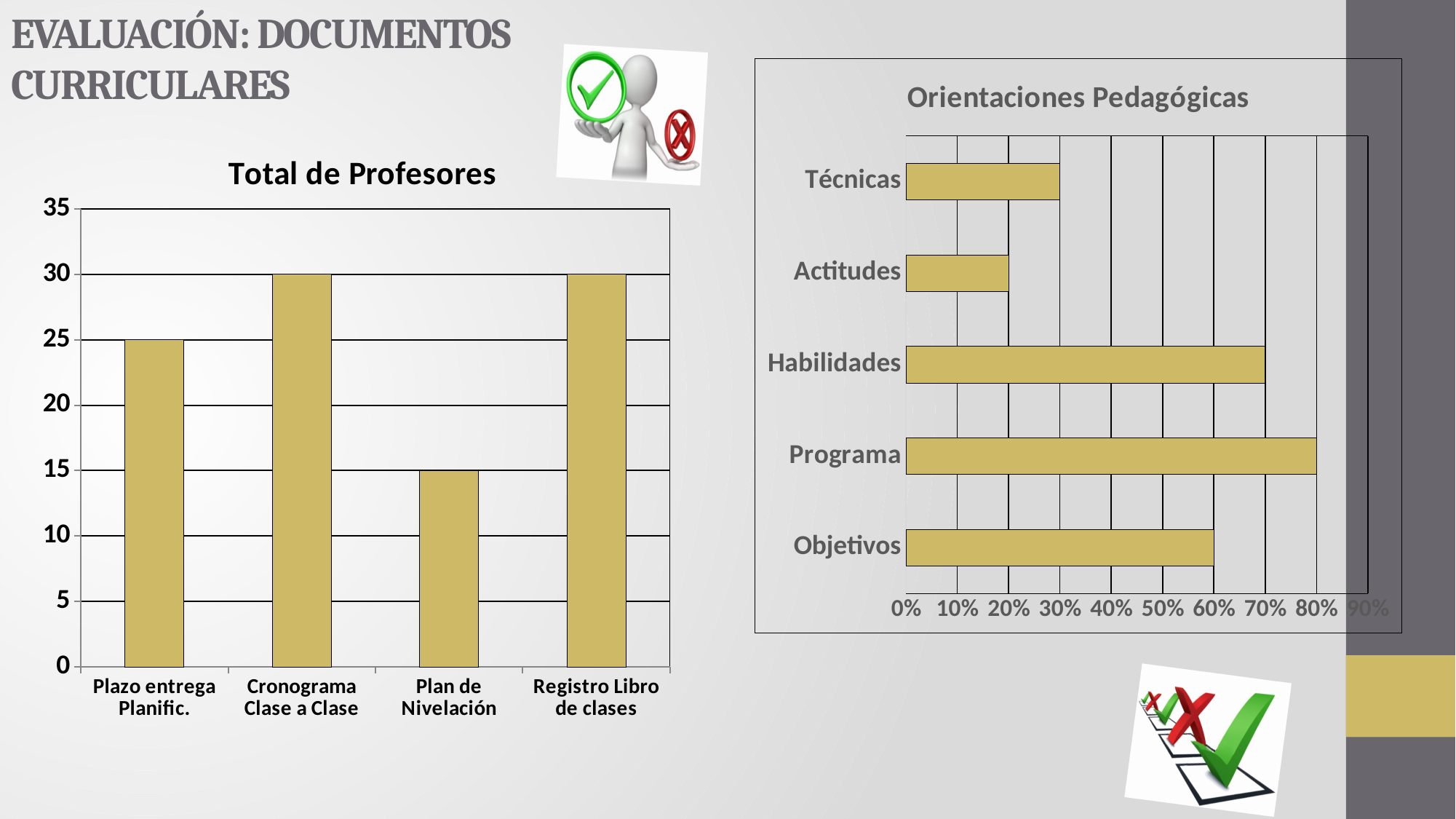
In the 'Total de Profesores' chart, what is the value for Plan de Nivelación? 15 In the 'Orientaciones Pedagógicas' chart, what is the value for Habilidades? 70% In the 'Orientaciones Pedagógicas' chart, what is the difference between Programa and Técnicas? 50% In the 'Orientaciones Pedagógicas' chart, how many categories are shown? 5 In the 'Total de Profesores' chart, what is the value for Plazo entrega Planific.? 25 In the 'Orientaciones Pedagógicas' chart, what is the value for Actitudes? 20% What kind of chart is 'Total de Profesores'? Bar chart In the 'Orientaciones Pedagógicas' chart, which category has the highest value? Programa In the 'Total de Profesores' chart, which category has the lowest value? Plan de Nivelación In the 'Total de Profesores' chart, what is the difference between Cronograma Clase a Clase and Plan de Nivelación? 15 In the 'Orientaciones Pedagógicas' chart, which is larger, Técnicas or Objetivos? Objetivos In the 'Total de Profesores' chart, how many categories are shown? 4